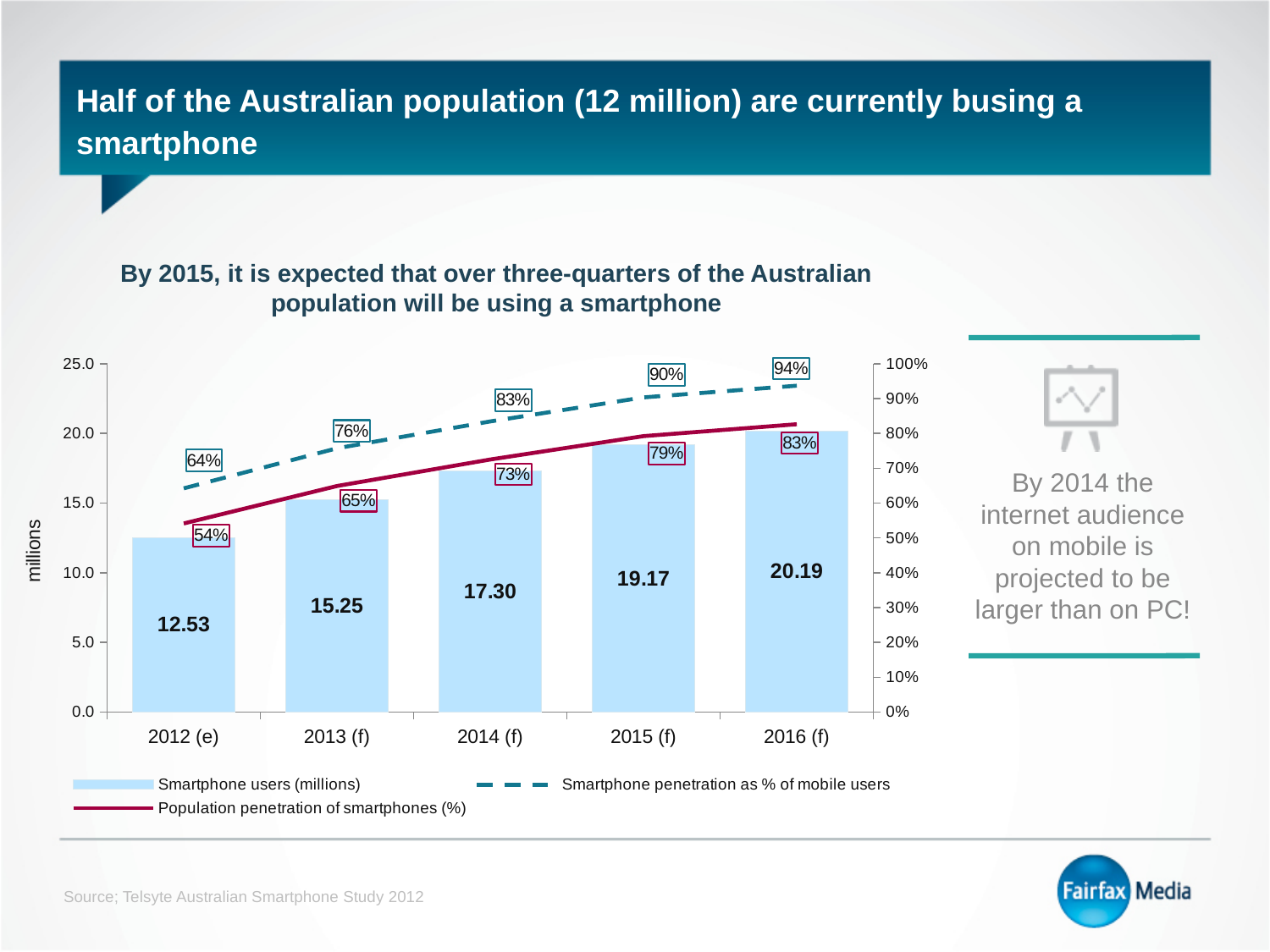
What is the Population penetration of smartphones (%) for 2015 (f)? 79% Which is larger in 2016 (f): Smartphone penetration as % of mobile users or Population penetration of smartphones (%)? Smartphone penetration as % of mobile users What is the Smartphone penetration as % of mobile users for 2013 (f)? 76% What is the label of the left vertical axis of the chart? millions How many years are shown on the x axis of the chart? 5 What is the value of Smartphone users (millions) for 2014 (f)? 17.30 Which year has the highest value for Smartphone users (millions)? 2016 (f) Do the values for Smartphone users (millions) rise or fall from 2012 (e) to 2016 (f)? rise What is the difference between Smartphone penetration as % of mobile users and Population penetration of smartphones (%) in 2014 (f)? 10% How many series does the chart legend list? 3 What is the difference in Smartphone users (millions) between 2016 (f) and 2012 (e)? 7.66 Which year has the lowest Population penetration of smartphones (%)? 2012 (e)